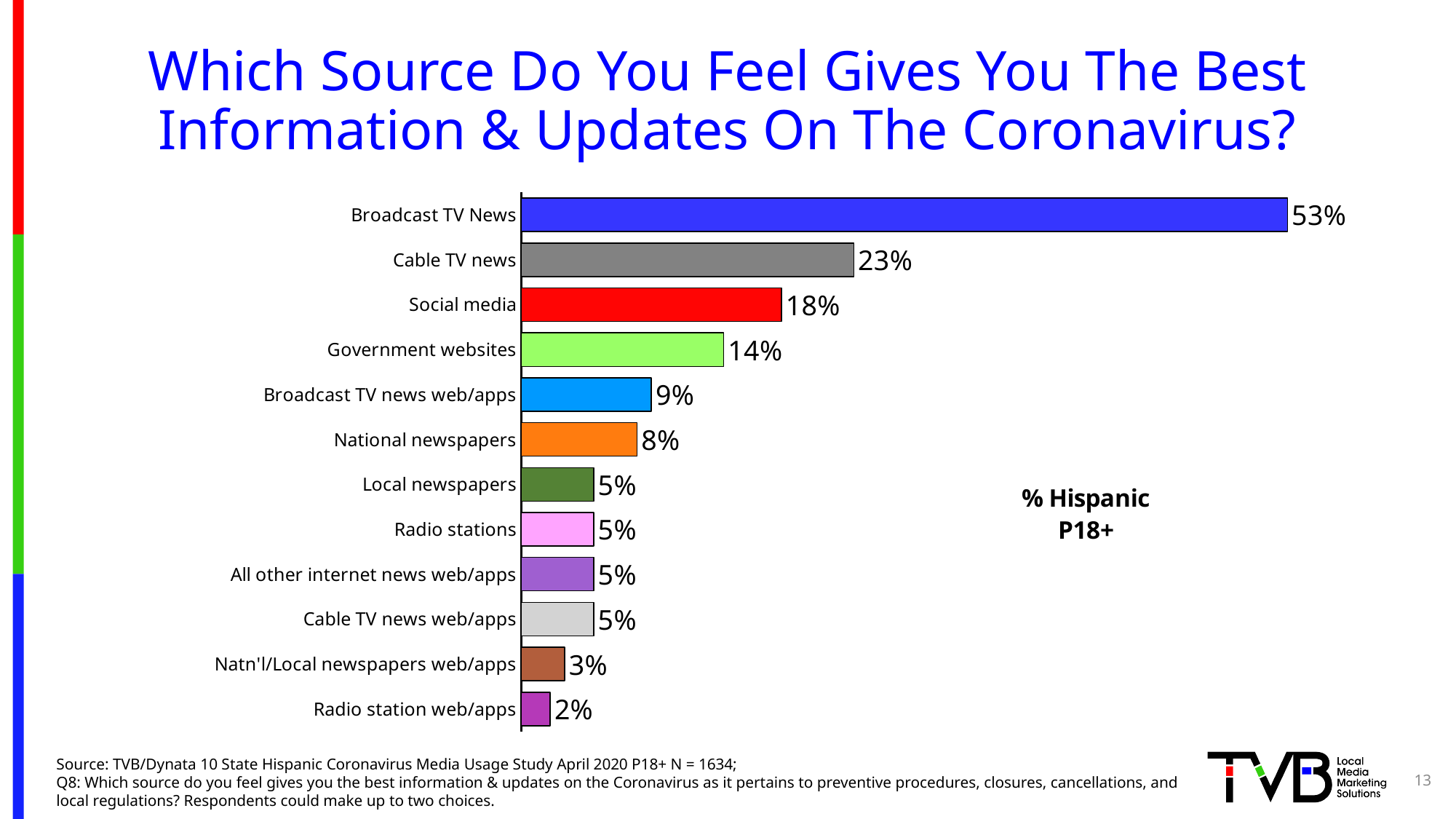
Which source has the lowest percentage on the chart? Radio station web/apps Which source has the highest percentage on the chart? Broadcast TV News What is the difference in percentage points between Broadcast TV News and Cable TV news? 30 What percentage of respondents chose Broadcast TV News as the source giving the best information on the Coronavirus? 53% What is the value shown for Natn'l/Local newspapers web/apps? 3% What kind of chart is shown on the slide? Bar chart What is the difference in percentage points between Social media and Government websites? 4 Which is larger, the value for Broadcast TV news web/apps or the value for National newspapers? Broadcast TV news web/apps How many sources share the value of 5%? 4 What audience label is printed next to the chart? % Hispanic P18+ How many sources (categories) are shown on the chart? 12 What is the value shown for Government websites? 14%